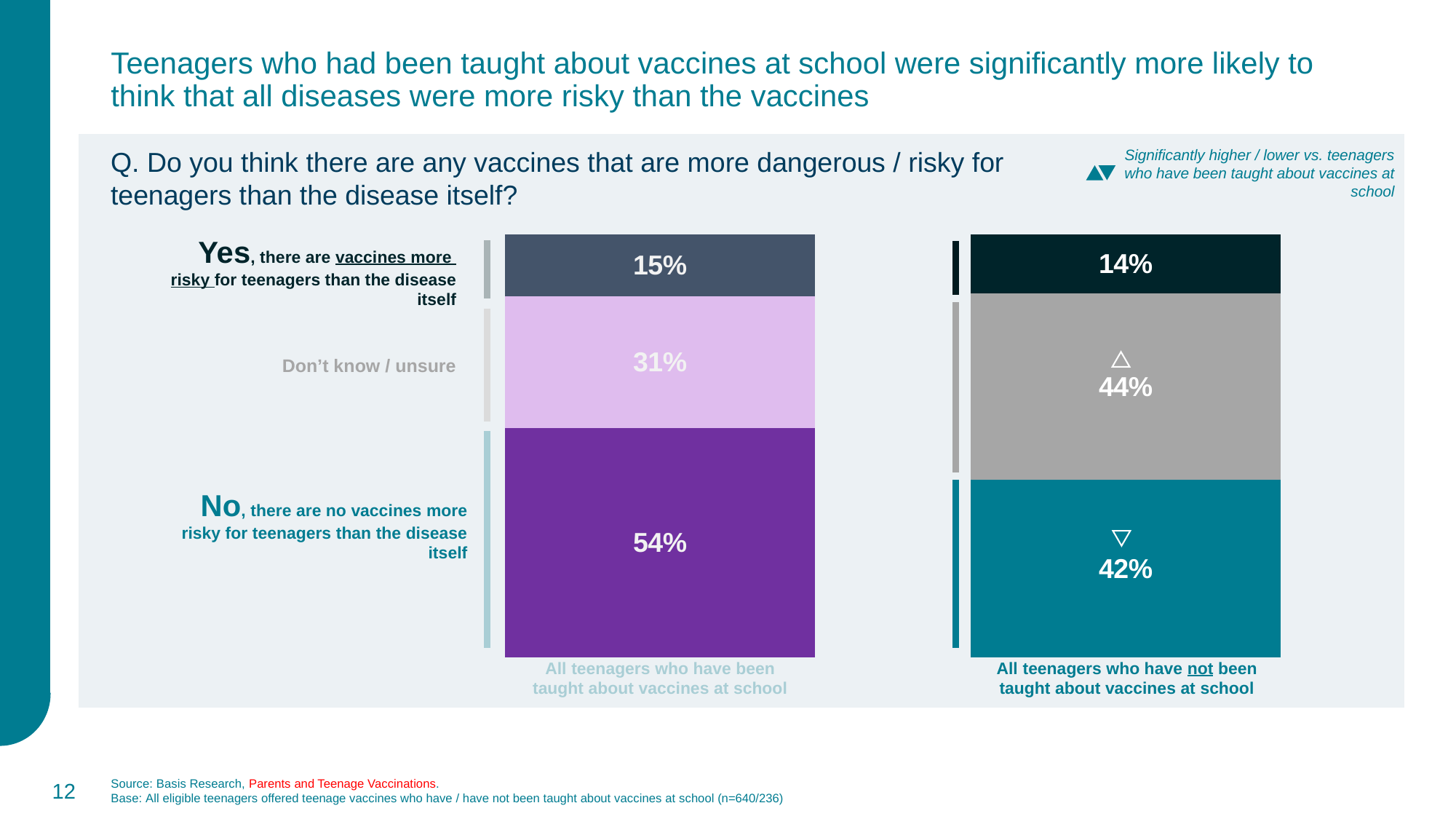
Which group has a larger Don't know / unsure share: teenagers taught about vaccines at school or those not taught? Teenagers who have not been taught about vaccines at school How many response categories are shown in each stacked bar? 3 Which response has the smallest share among teenagers who have not been taught about vaccines at school? Yes, there are vaccines more risky for teenagers than the disease itself What type of chart is shown on the slide? Stacked bar chart What percentage of teenagers who have been taught about vaccines at school said No, there are no vaccines more risky for teenagers than the disease itself? 54% What percentage of teenagers who have been taught about vaccines at school said Yes, there are vaccines more risky for teenagers than the disease itself? 15% What percentage of teenagers who have not been taught about vaccines at school answered Don't know / unsure? 44% What percentage of teenagers who have not been taught about vaccines at school said No, there are no vaccines more risky than the disease itself? 42% What is the difference in percentage points between the Don't know / unsure share for teenagers not taught about vaccines at school and those who were taught? 13 Which response has the largest share among teenagers who have been taught about vaccines at school? No, there are no vaccines more risky for teenagers than the disease itself How many percentage points higher is the No response among teenagers taught about vaccines at school than among those not taught? 12 What is the total of the three segments in the bar for teenagers who have been taught about vaccines at school? 100%